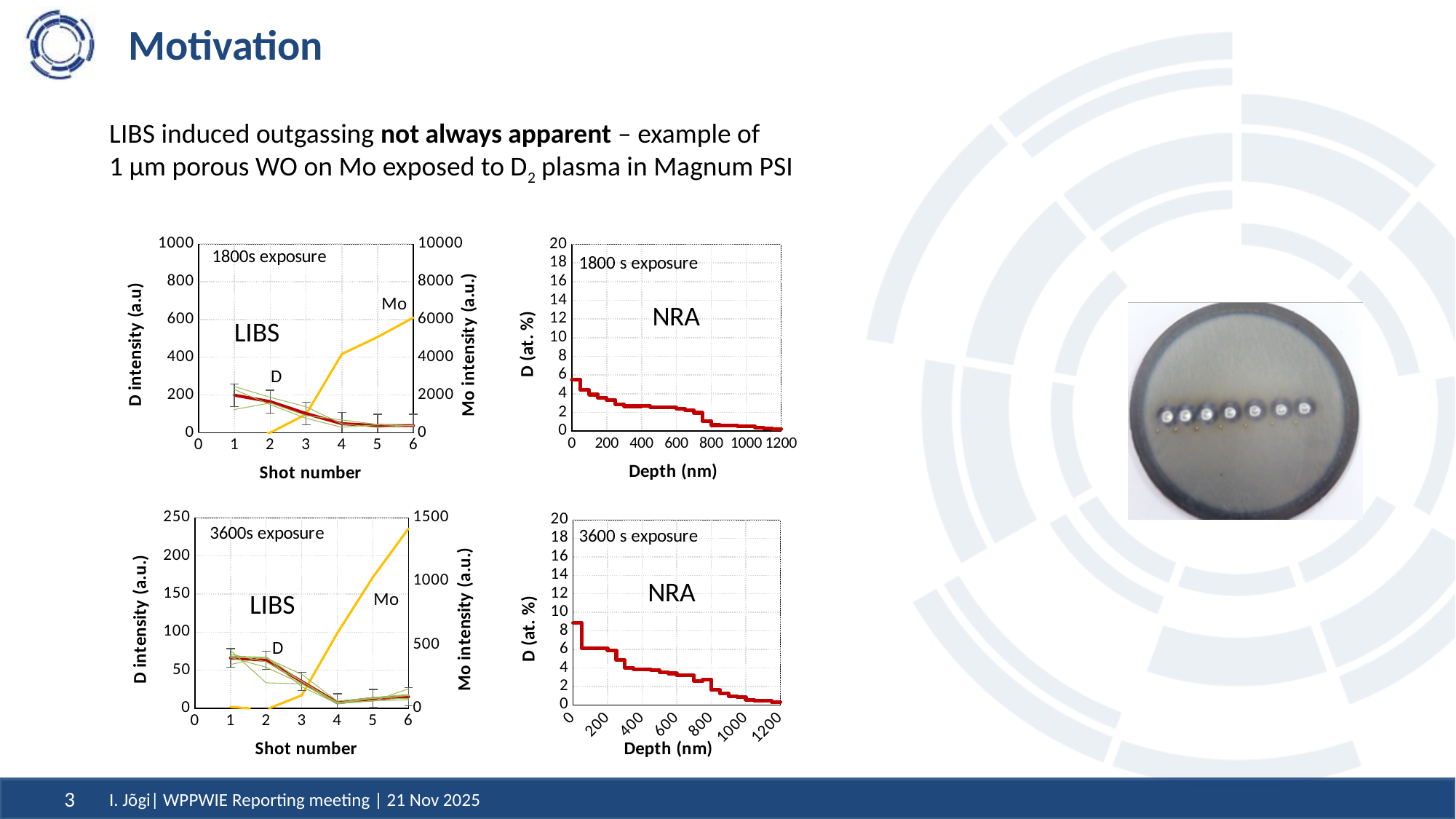
In the top-left LIBS chart (1800s exposure), is the D intensity at shot 1 greater or less than 400? less In the top-right NRA chart (1800 s exposure), is the D concentration at depth 0 greater or less than 10 at.%? less In the bottom-left LIBS chart (3600s exposure), is the Mo intensity at shot 6 greater or less than 1000? greater In the top-right NRA chart (1800 s exposure), does the D concentration rise or fall as depth increases? fall In the top-left LIBS chart (1800s exposure), does the Mo intensity rise or fall as the shot number increases from 2 to 6? rise In the top-left LIBS chart (1800s exposure), does the D intensity rise or fall as the shot number increases? fall In the bottom-left LIBS chart (3600s exposure), what is the label of the x axis? Shot number In the top-left LIBS chart (1800s exposure), what kind of chart is it? line chart In the bottom-right NRA chart (3600 s exposure), what is the label of the x axis? Depth (nm)